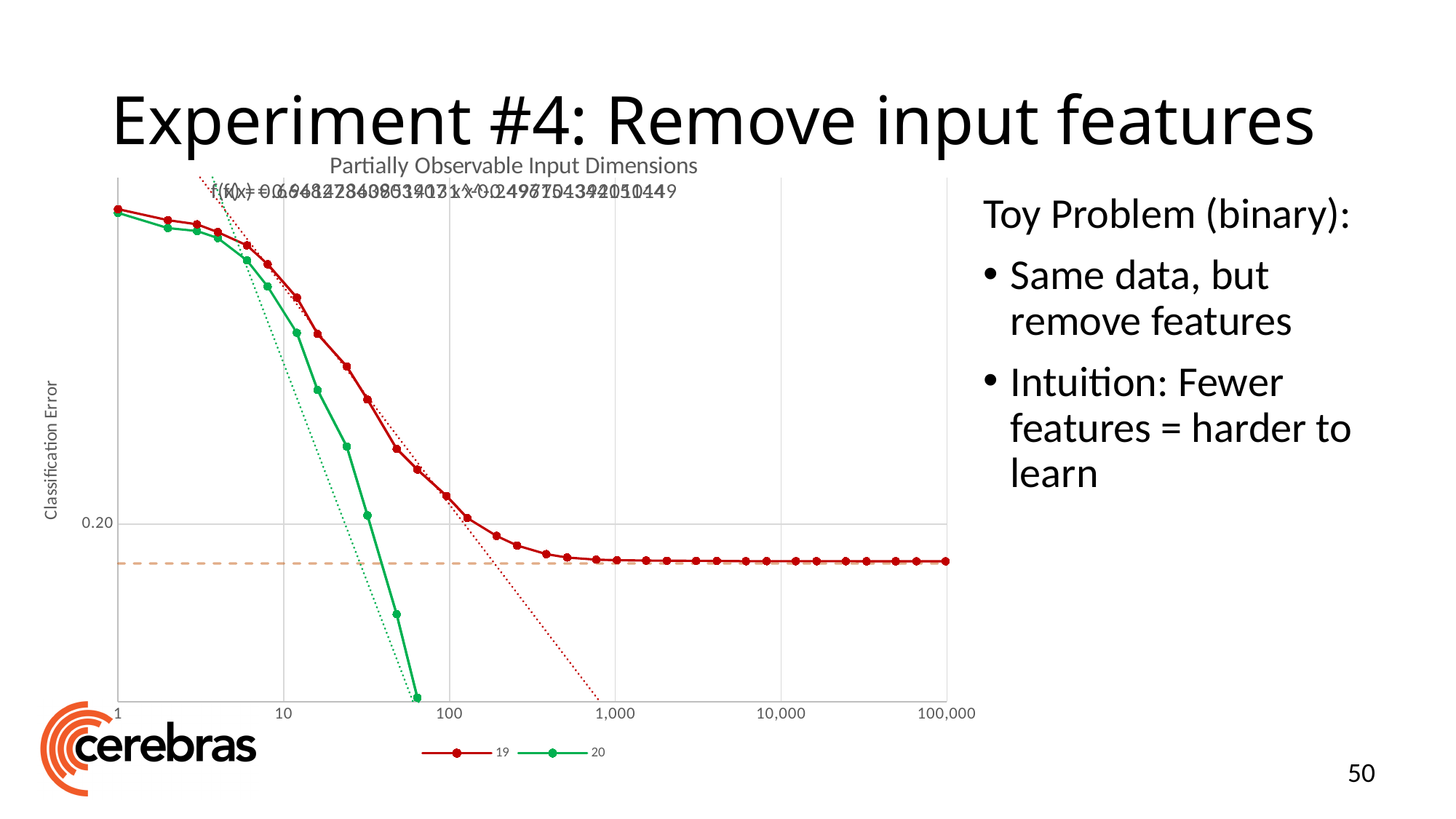
Do the values of series 19 rise or fall as the x axis increases? fall What are the two series names shown in the chart legend? 19 and 20 Is the value of series 19 at x = 10 greater or less than 0.20? greater Which series reaches the lowest classification error on the chart, 19 or 20? 20 Is the value of series 20 at x = 10 greater or less than 0.20? greater What is the title of the chart? Partially Observable Input Dimensions At x = 10, which series has the higher classification error, 19 or 20? 19 Is the value of series 19 at x = 100,000 greater or less than 0.20? less Do the values of series 20 rise or fall as the x axis increases? fall What kind of chart is shown on the slide? line chart How many labeled tick marks are shown on the x axis? 6 How many series does the chart legend list? 2